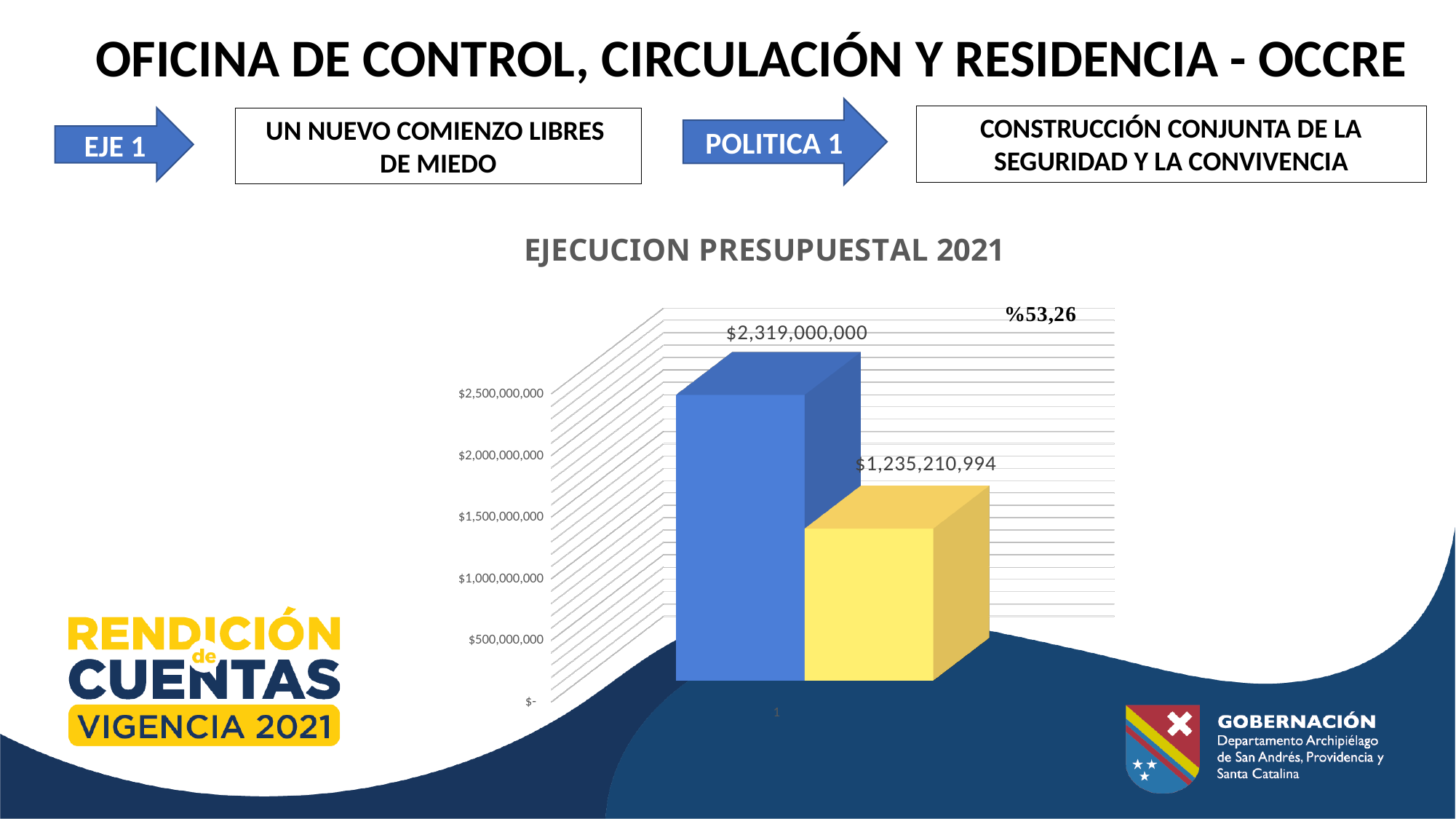
What is the title of the chart? EJECUCION PRESUPUESTAL 2021 Is the value of the yellow bar greater or less than $1,500,000,000? less What is the difference between the blue bar value and the yellow bar value? $1,083,789,006 What percentage is annotated at the top right of the chart? %53,26 What type of chart is shown on the slide? bar chart Which bar has the higher value, the blue bar or the yellow bar? the blue bar What is the value shown on the blue bar? $2,319,000,000 Which bar shows the lowest value? the yellow bar How many bars are plotted in the chart? 2 Is the value of the blue bar greater or less than $2,000,000,000? greater What is the value shown on the yellow bar? $1,235,210,994 What is the highest value labelled on the vertical axis? $2,500,000,000